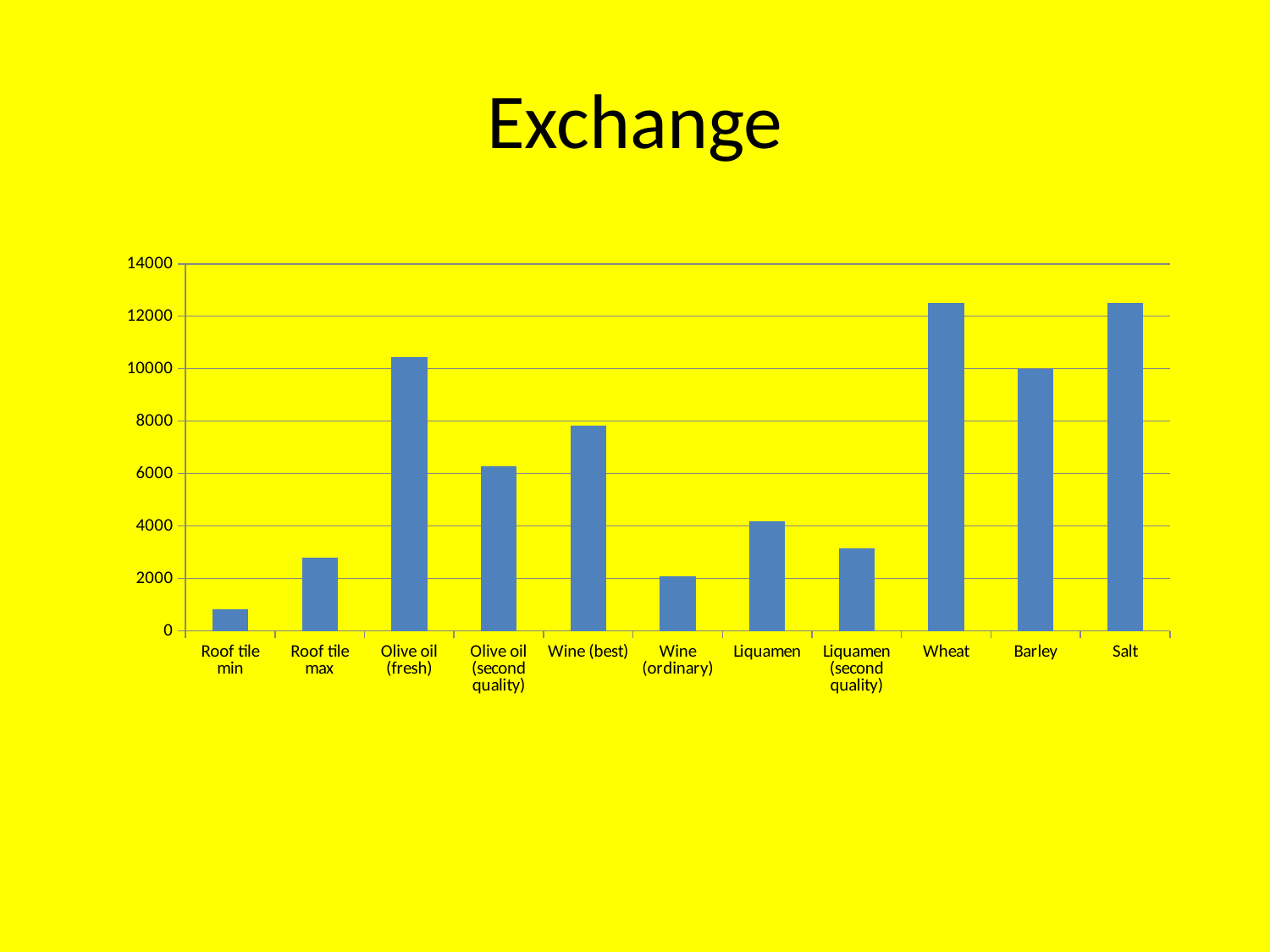
What is the title of the slide? Exchange Is the value for Liquamen (second quality) greater or less than 2000? greater Which is larger, the value for Roof tile max or the value for Liquamen? Liquamen Is the value for Wheat greater or less than 12000? greater Is the value for Roof tile min greater or less than 2000? less Which category has the lowest value? Roof tile min What kind of chart is shown on the slide? bar chart Which is larger, the value for Wine (best) or the value for Olive oil (second quality)? Wine (best) What is the value for Barley? 10000 How many categories are plotted on the chart? 11